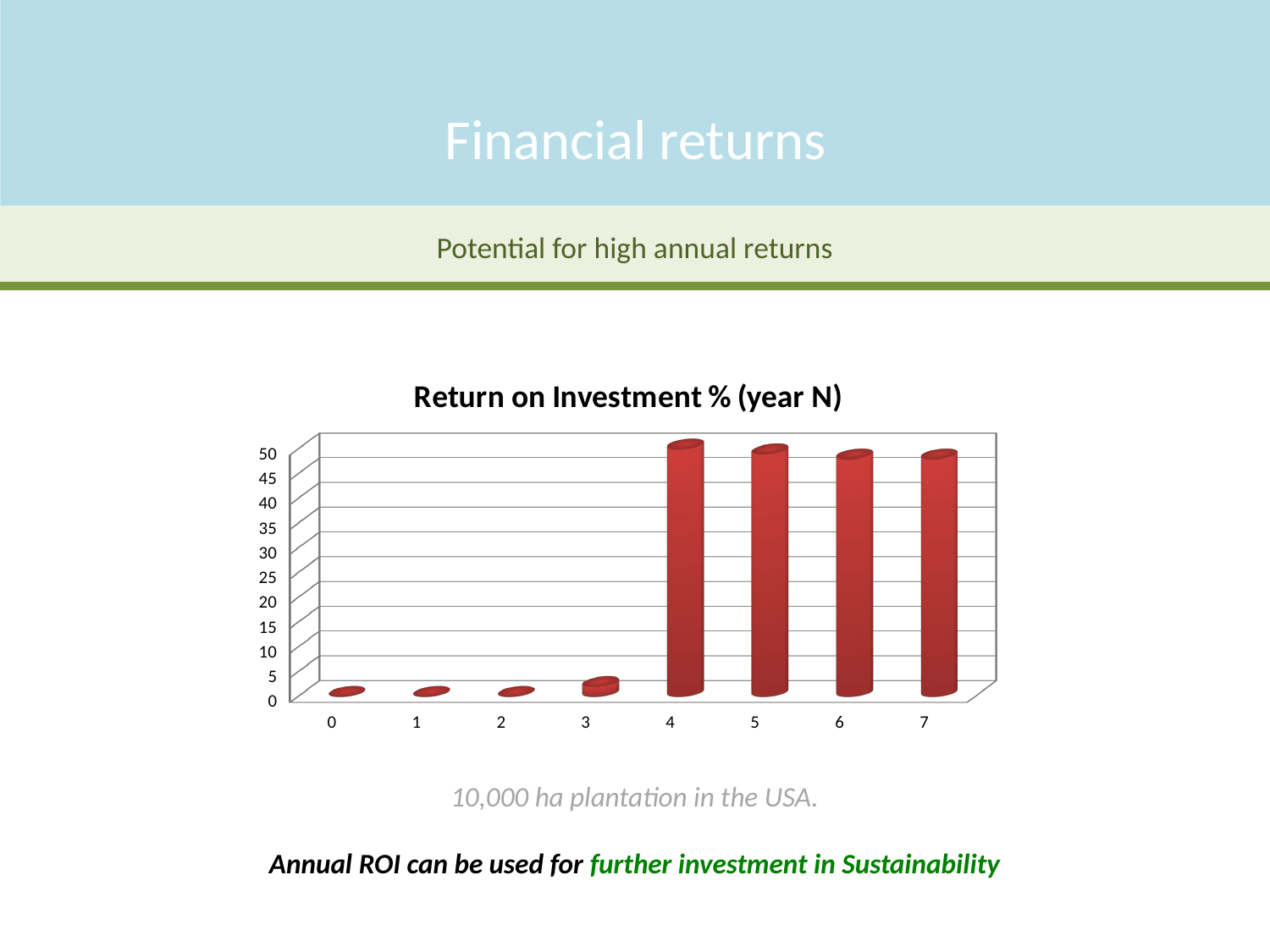
Which has the larger value, year 3 or year 4? year 4 What is the title of the chart? Return on Investment % (year N) Is the value for year 4 greater or less than 40? greater How many categories (years) are shown on the x axis of the chart? 8 Which has the larger value, year 2 or year 3? year 3 What kind of chart is shown on the slide? bar chart Is the value for year 7 greater or less than 30? greater Is the value for year 5 greater or less than 40? greater Do the values rise or fall from year 0 to year 4? rise What colour are the bars in the chart? red